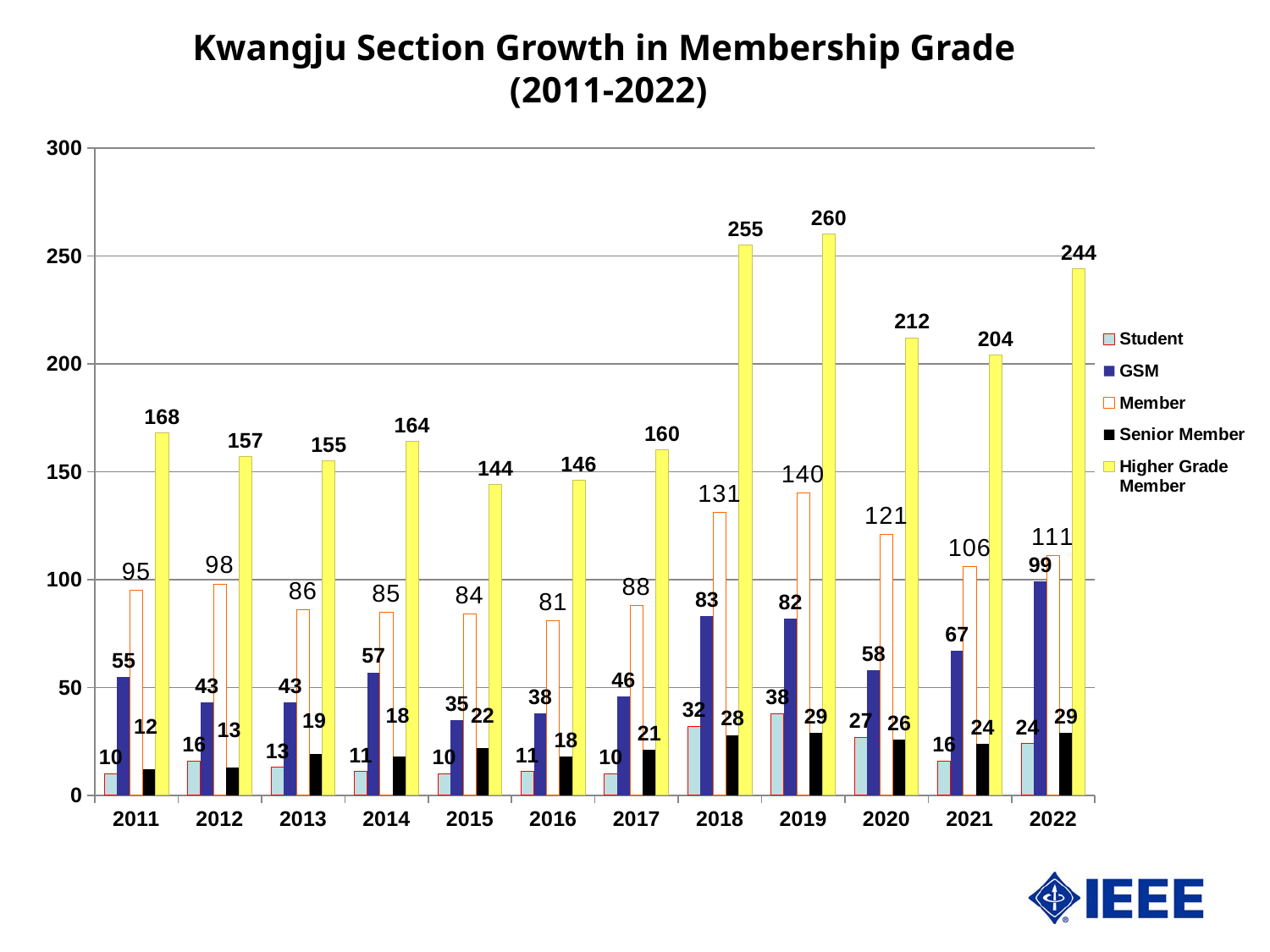
What is the value for Higher Grade Member in 2019? 260 What is the difference between the Higher Grade Member values for 2022 and 2021? 40 What kind of chart is shown on the slide? Bar chart What is the value for Member in 2018? 131 In which year is the Higher Grade Member value highest? 2019 What is the value for Senior Member in 2015? 22 In 2022, which is larger: GSM or Member? Member How many years are shown on the x axis? 12 How many series does the legend list? 5 What colour represents Higher Grade Member in the legend? Yellow In which year is the Student value highest? 2019 In which year is the GSM value lowest? 2015